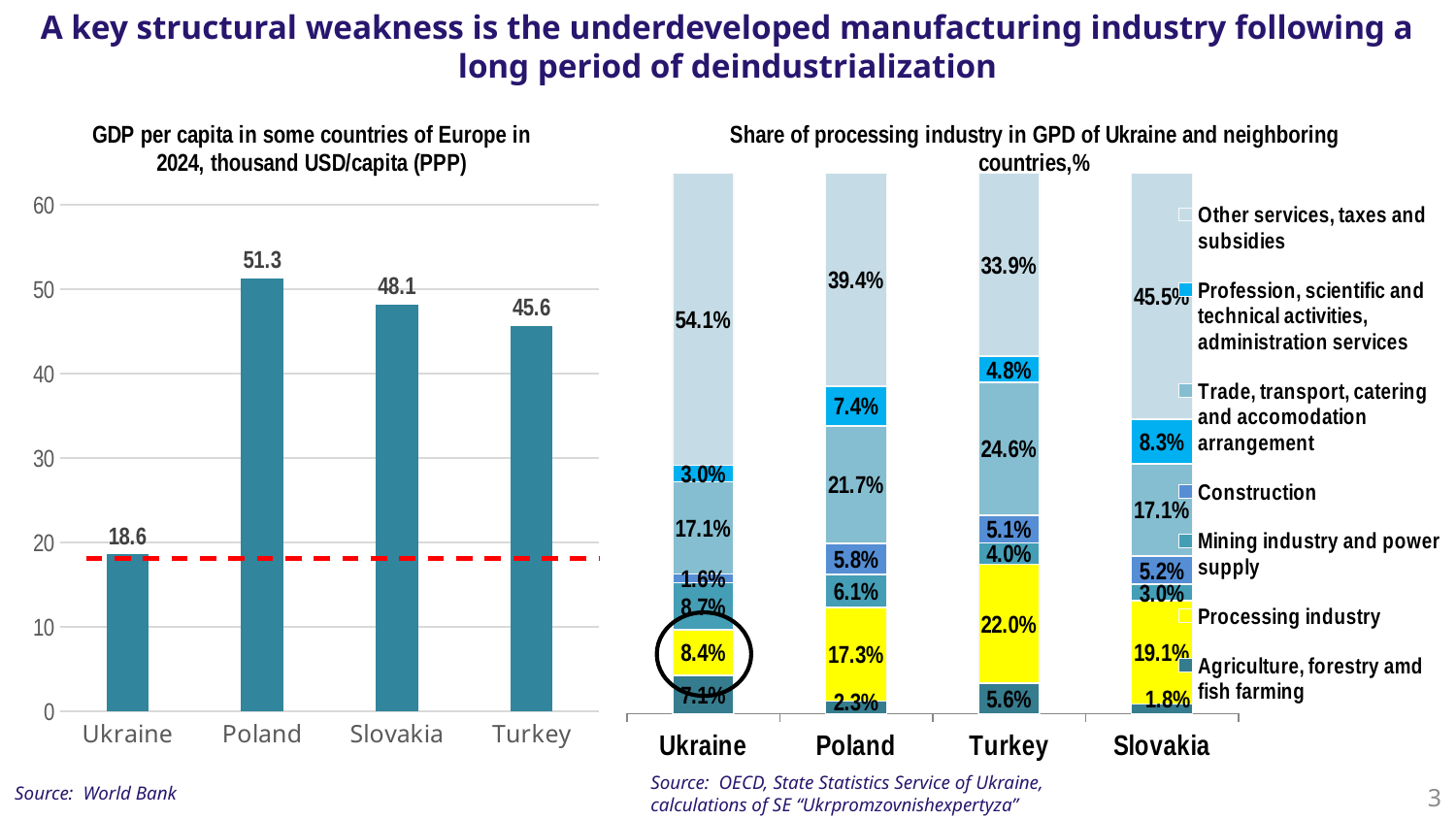
In the left chart (GDP per capita in 2024), which country has the highest GDP per capita? Poland In the left chart (GDP per capita in 2024), which is larger, the value for Slovakia or the value for Turkey? Slovakia In the left chart (GDP per capita in 2024), what is the difference between Poland's and Ukraine's values? 32.7 In the right chart (Share of processing industry in GDP), which country has the lowest share of processing industry? Ukraine In the left chart (GDP per capita in 2024), how many countries are shown? 4 In the right chart (Share of processing industry in GDP), what is the share of processing industry for Turkey? 22.0% What type of chart is the left chart (GDP per capita in 2024)? Bar chart In the left chart (GDP per capita in 2024), what is the value for Poland? 51.3 In the right chart (Share of processing industry in GDP), what is the difference between the processing industry shares of Turkey and Poland? 4.7% In the right chart (Share of processing industry in GDP), what is the share of processing industry for Ukraine? 8.4% How many series does the legend of the right chart (Share of processing industry in GDP) list? 7 In the left chart (GDP per capita in 2024), which country has the lowest GDP per capita? Ukraine